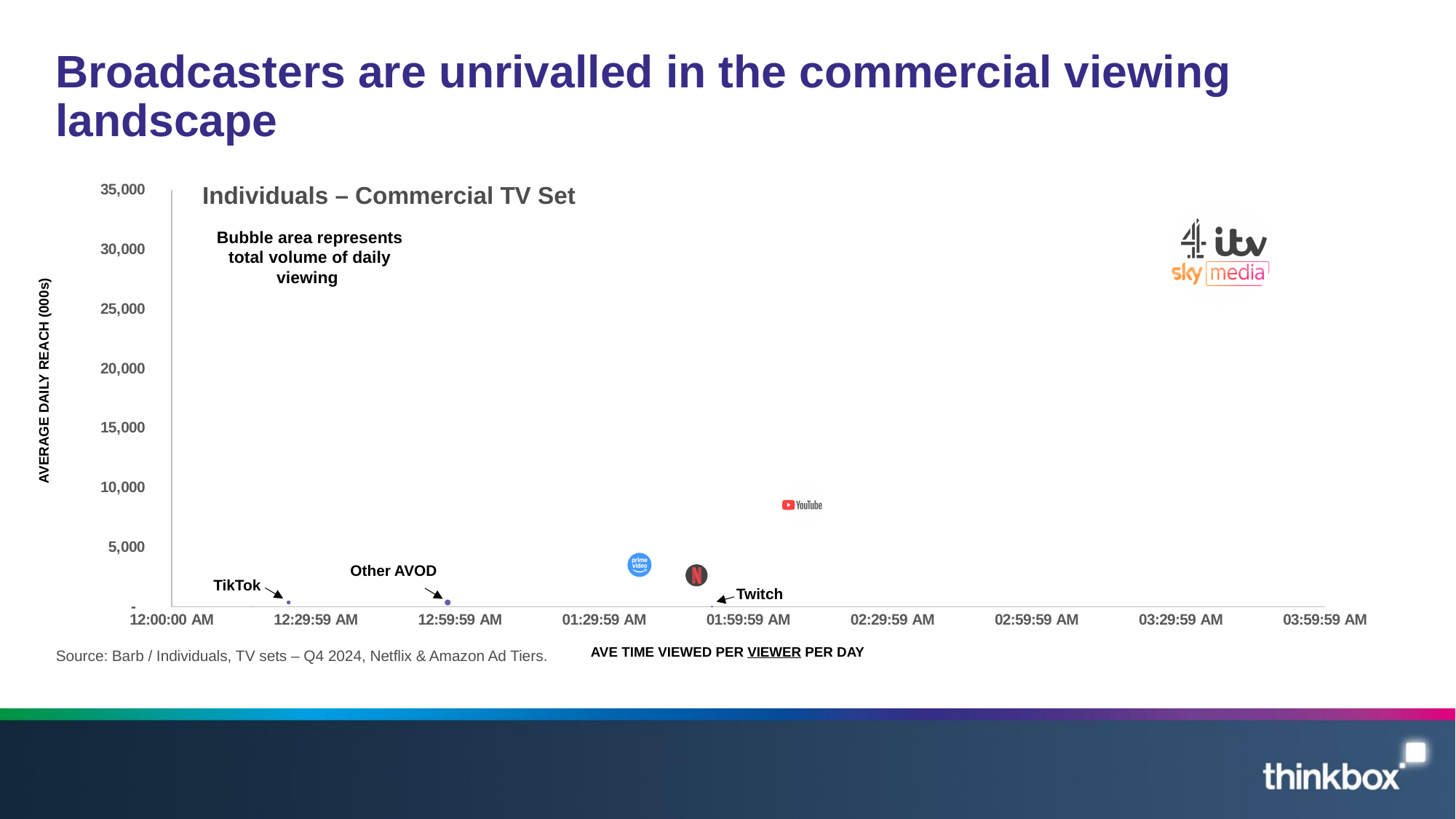
Is the average daily reach for Prime Video greater or less than 5,000? less Which plotted service has the lowest average time viewed per viewer per day? TikTok Which plotted group has the highest average daily reach? The broadcasters (Channel 4, ITV, Sky Media) Is the average daily reach for the broadcasters (Channel 4, ITV, Sky Media) greater or less than 25,000? greater According to the note on the chart, what does the bubble area represent? Total volume of daily viewing Is the average daily reach for YouTube greater or less than 10,000? less Which has the higher average daily reach, YouTube or Netflix? YouTube What kind of chart is shown on the slide? Bubble chart Which has the longer average time viewed per viewer per day, YouTube or Prime Video? YouTube What is the title of the chart? Individuals – Commercial TV Set